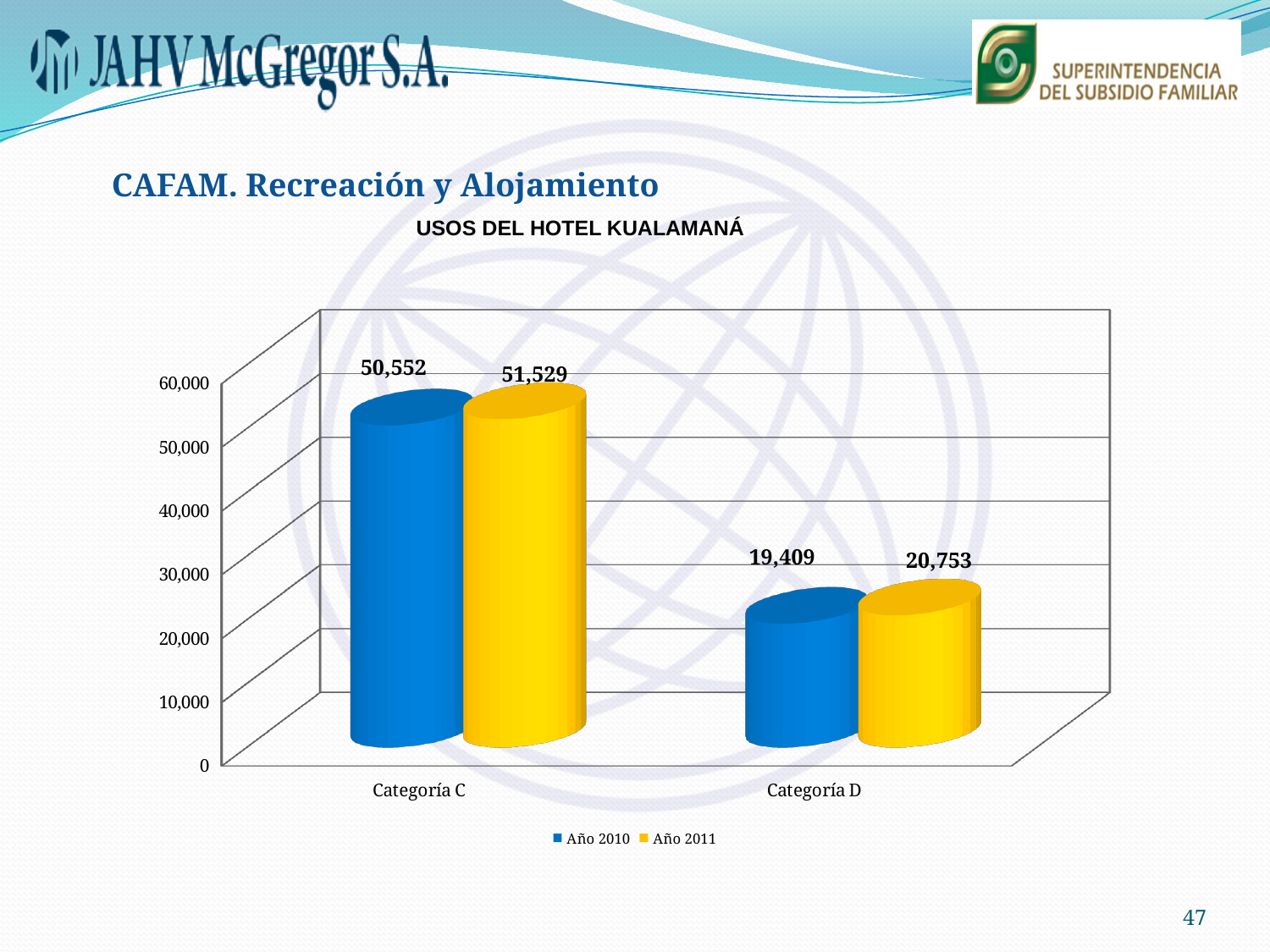
What is the value for Categoría C in Año 2010? 50,552 What is the value for Categoría D in Año 2010? 19,409 What is the value for Categoría C in Año 2011? 51,529 Which category has the lowest value in Año 2010? Categoría D How many series does the legend list? 2 What is the value for Categoría D in Año 2011? 20,753 What is the title of the chart? USOS DEL HOTEL KUALAMANÁ How many categories are shown on the x axis? 2 What is the difference between the Año 2011 and Año 2010 values for Categoría C? 977 What is the difference between the Año 2011 and Año 2010 values for Categoría D? 1,344 Which category has the highest value in Año 2011? Categoría C Which is larger for Categoría C: Año 2010 or Año 2011? Año 2011